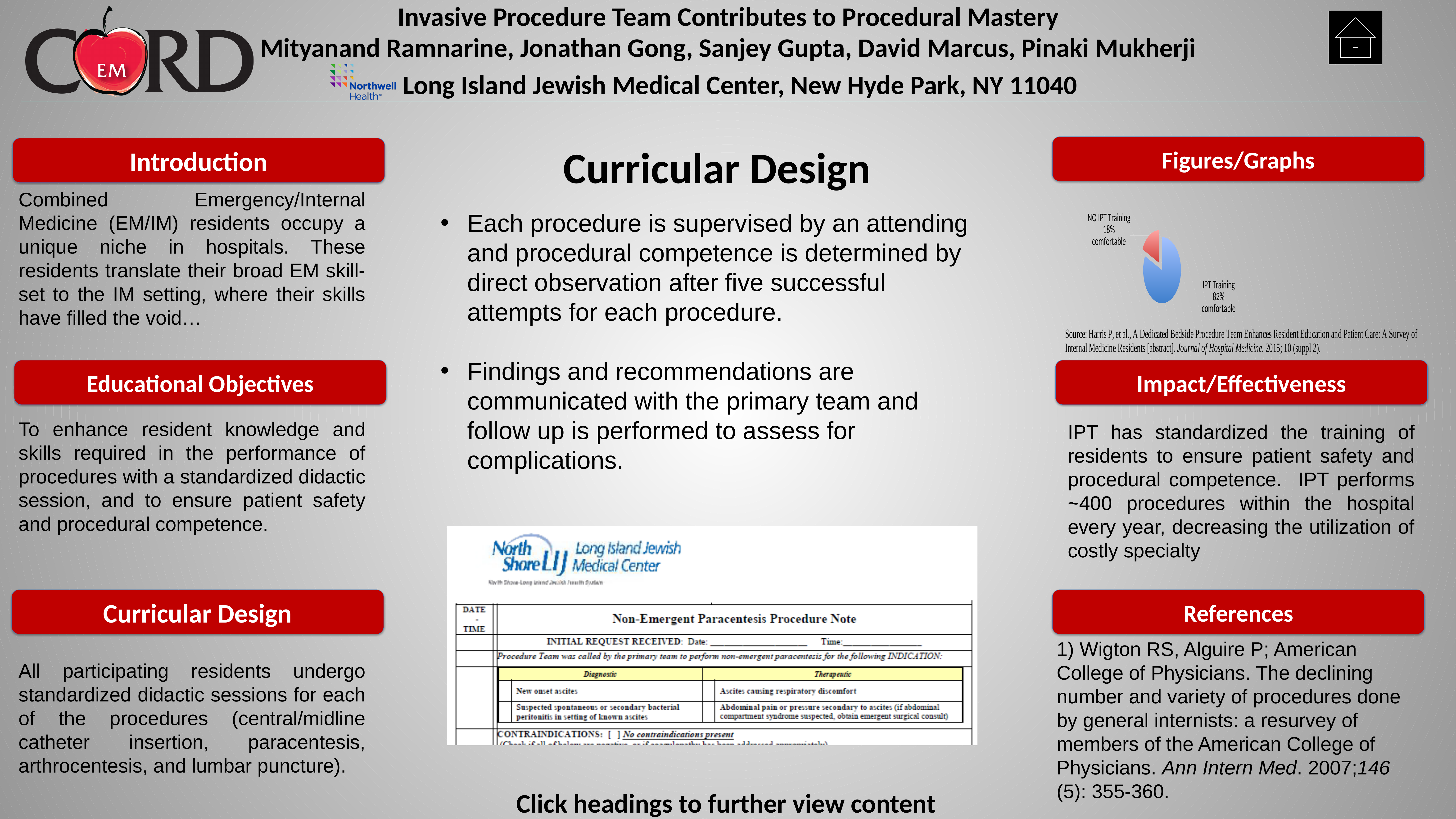
What share of the pie does the IPT Training slice represent? 82% In the pie chart, what percentage is shown for NO IPT Training? 18% Which slice of the pie chart is the smallest? NO IPT Training Which is larger in the pie chart: IPT Training or NO IPT Training? IPT Training What kind of chart is shown in the Figures/Graphs section? pie chart What is the difference in percentage points between the IPT Training and NO IPT Training slices? 64 What colour is the NO IPT Training slice in the pie chart? red How many slices does the pie chart have? 2 Which slice of the pie chart is the largest? IPT Training What colour is the IPT Training slice in the pie chart? blue In the pie chart, what percentage is shown for IPT Training? 82%